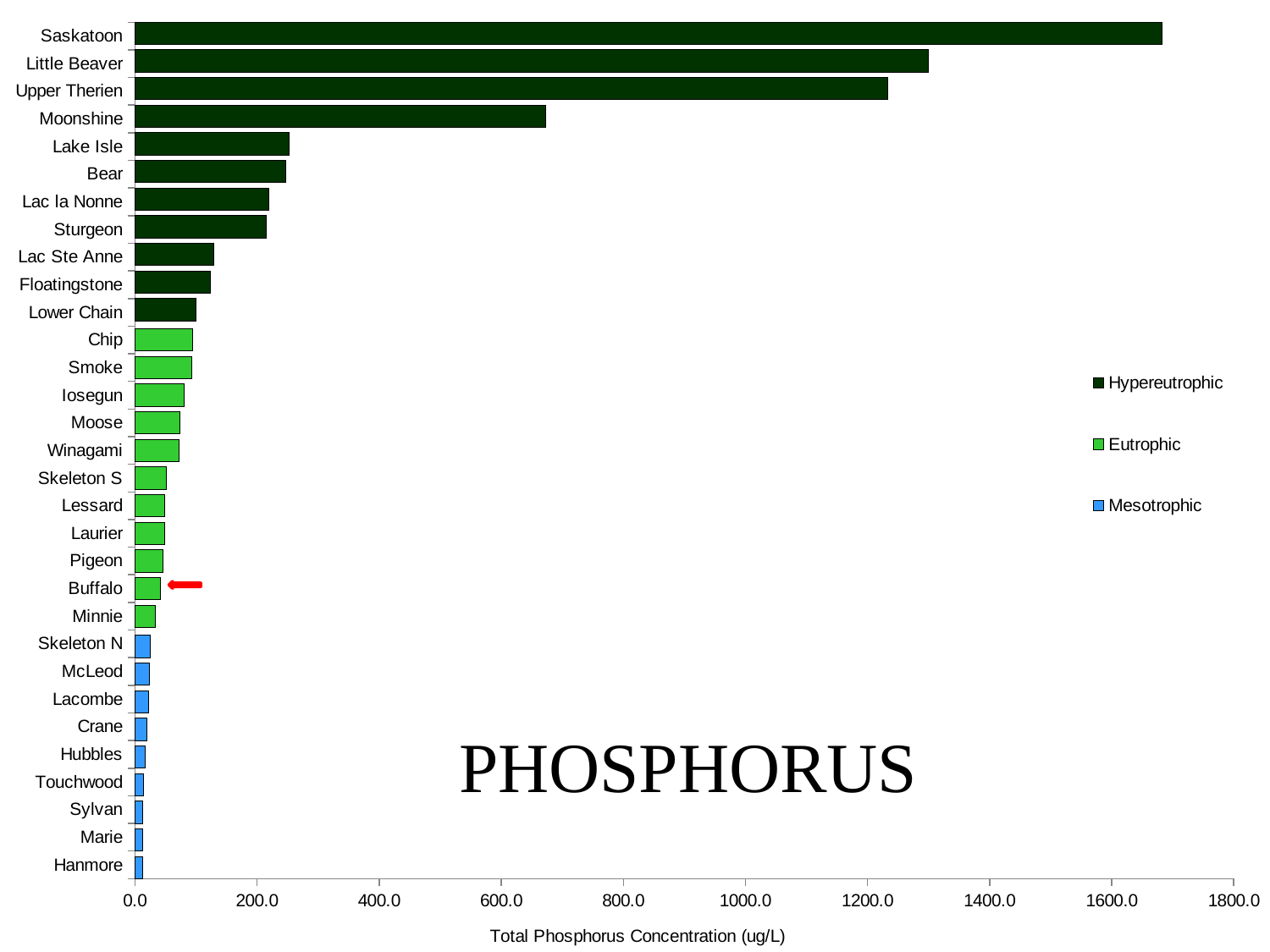
How many lakes are listed on the chart? 31 How many series does the legend list? 3 Is the value for Lower Chain greater or less than 200.0? less Is the value for Little Beaver greater or less than 1200.0? greater Which has a larger total phosphorus concentration, Sturgeon or Lac Ste Anne? Sturgeon Is the value for Saskatoon greater or less than 1600.0? greater Which has a larger total phosphorus concentration, Moonshine or Lake Isle? Moonshine What kind of chart is shown on the slide? bar chart Which lake's bar is marked with a red arrow? Buffalo Which lake has the highest total phosphorus concentration? Saskatoon What is the title of the x axis? Total Phosphorus Concentration (ug/L)